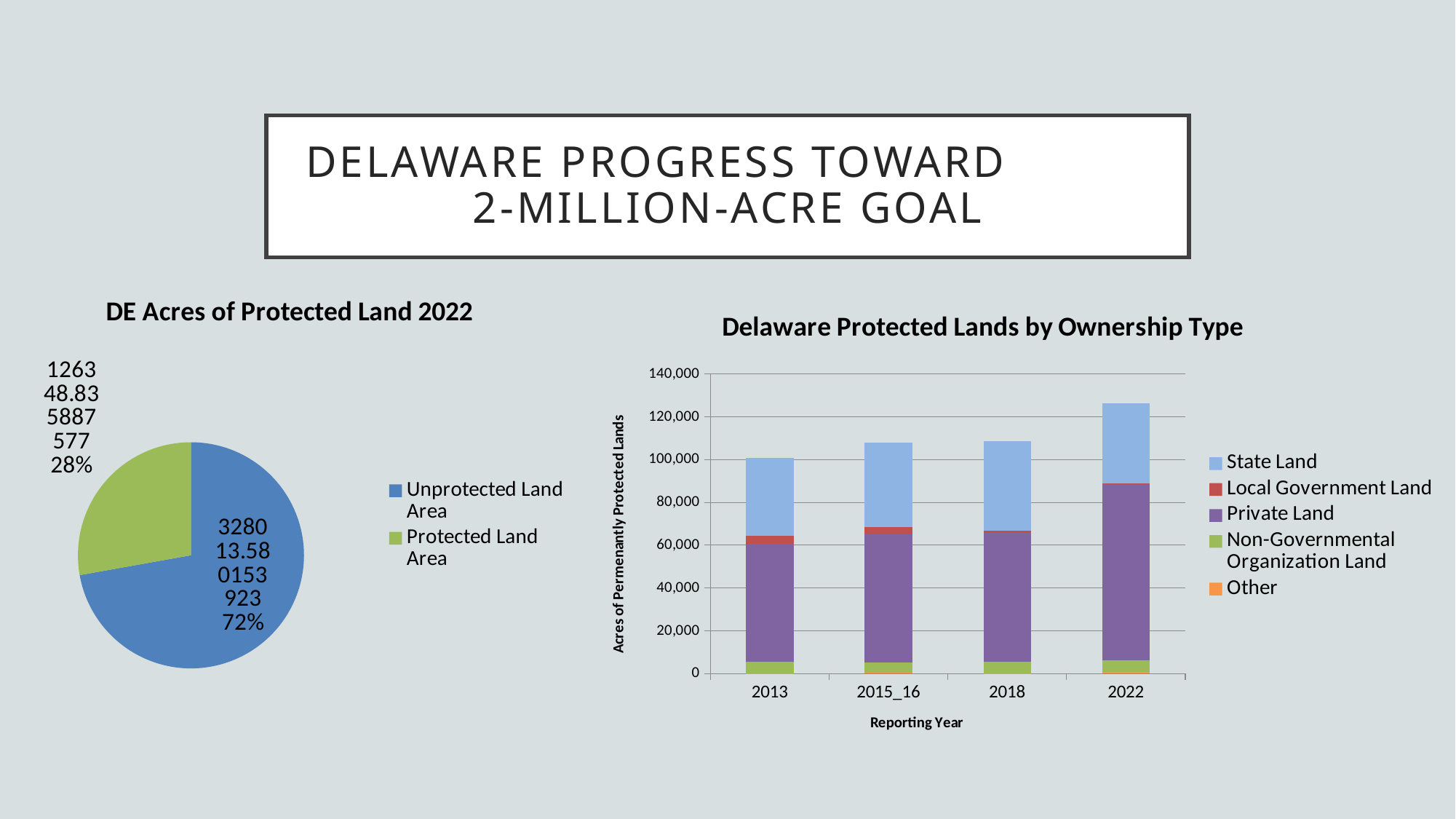
In the pie chart 'DE Acres of Protected Land 2022', what share of the pie is Unprotected Land Area? 72% In the pie chart 'DE Acres of Protected Land 2022', what share of the pie is Protected Land Area? 28% What kind of chart is 'Delaware Protected Lands by Ownership Type'? Stacked bar chart How many slices does the pie chart 'DE Acres of Protected Land 2022' have? 2 In the pie chart 'DE Acres of Protected Land 2022', which slice is larger, Unprotected Land Area or Protected Land Area? Unprotected Land Area How many series does the legend of 'Delaware Protected Lands by Ownership Type' list? 5 How many reporting years are shown on the x axis of 'Delaware Protected Lands by Ownership Type'? 4 In 'Delaware Protected Lands by Ownership Type', which reporting year has the tallest stacked bar? 2022 What is the y-axis title of the chart 'Delaware Protected Lands by Ownership Type'? Acres of Permenantly Protected Lands In 'Delaware Protected Lands by Ownership Type', which reporting year has the shortest stacked bar? 2013 In 'Delaware Protected Lands by Ownership Type', is the total stacked bar for 2022 greater or less than 120,000? greater In 'Delaware Protected Lands by Ownership Type', do the total acres of protected land rise or fall from 2013 to 2022? rise